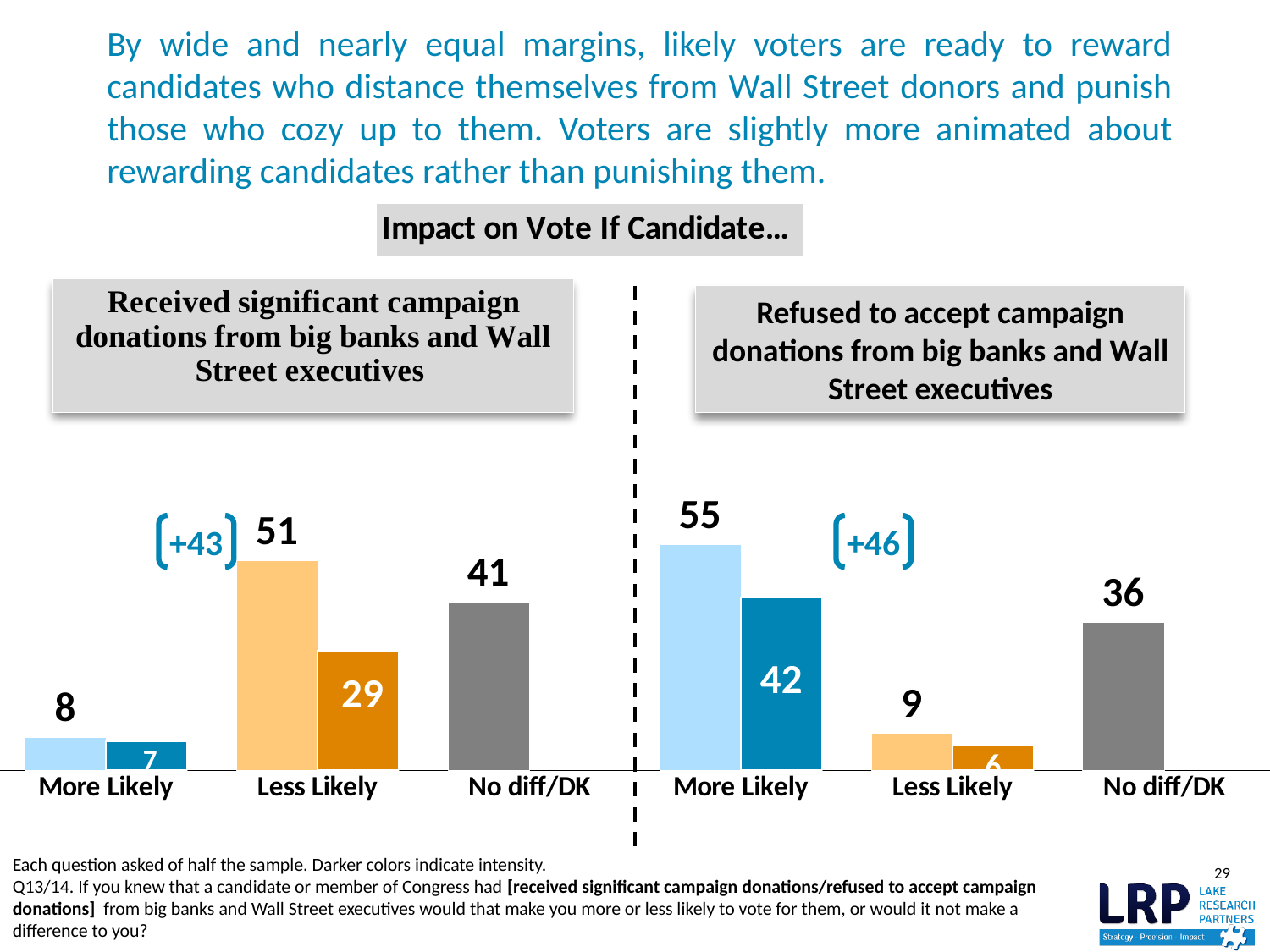
What kind of chart is used on this slide? Bar chart In the right chart (Refused to accept campaign donations), which category has the lowest total value? Less Likely In the left chart (Received significant campaign donations), what is the total value for Less Likely? 51 How many categories are shown on the x axis of the left chart (Received significant campaign donations)? 3 In the left chart (Received significant campaign donations), what is the value for No diff/DK? 41 In the right chart (Refused to accept campaign donations), what is the difference between the More Likely total (55) and the No diff/DK value (36)? 19 In the right chart (Refused to accept campaign donations), what is the value for No diff/DK? 36 In the right chart (Refused to accept campaign donations), what is the total value for More Likely? 55 Which is larger: the More Likely total in the right chart (Refused to accept) or the Less Likely total in the left chart (Received donations)? More Likely in the right chart (55) In the left chart (Received significant campaign donations), what is the difference between the Less Likely total (51) and the No diff/DK value (41)? 10 In the right chart (Refused to accept campaign donations), what is the darker (intensity) value for More Likely? 42 In the left chart (Received significant campaign donations), which category has the highest total value? Less Likely